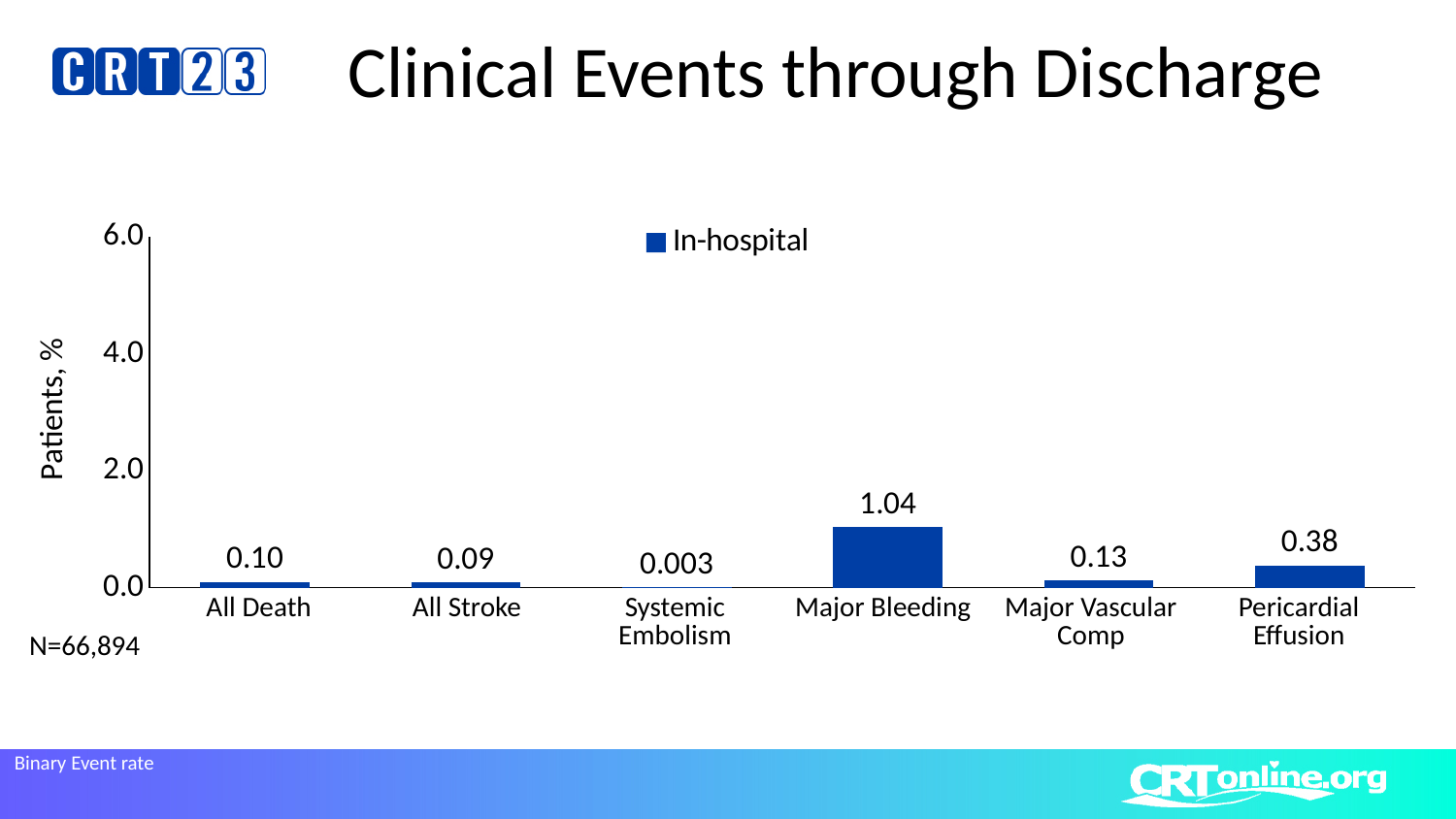
What is the in-hospital rate for Pericardial Effusion? 0.38 How many categories are shown on the x axis? 6 How many series does the legend list? 1 Is the value for Major Bleeding greater or less than 2.0? less What is the difference between the Major Bleeding rate and the Pericardial Effusion rate? 0.66 Which is larger, the rate for Major Vascular Comp or the rate for All Stroke? Major Vascular Comp Which category has the lowest in-hospital rate? Systemic Embolism What kind of chart is shown on the slide? bar chart What is the in-hospital rate for Systemic Embolism? 0.003 Which category has the highest in-hospital rate? Major Bleeding What is the in-hospital rate for All Death? 0.10 What is the in-hospital rate for Major Bleeding? 1.04